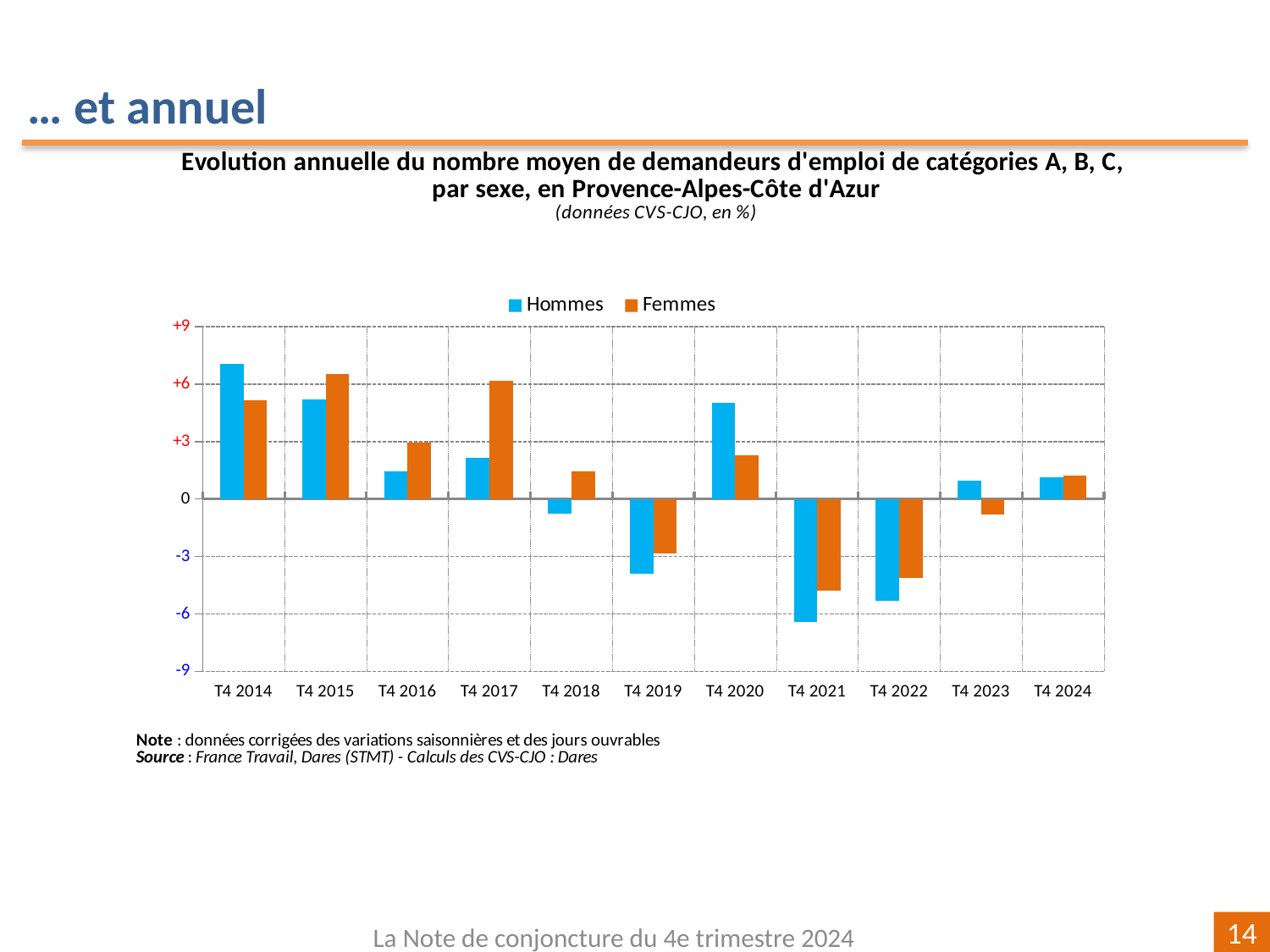
What kind of chart is shown on the slide? bar chart Is the Femmes value for T4 2021 greater or less than -3? less In which quarter is the Hommes value lowest? T4 2021 Is the Hommes value for T4 2014 greater or less than +6? greater In which quarter is the Femmes value lowest? T4 2021 For T4 2017, which series has the larger value, Hommes or Femmes? Femmes How many quarters (categories) are shown on the x axis? 11 Which colour represents the Hommes series in the legend? blue How many series does the legend list? 2 For T4 2020, which series has the larger value, Hommes or Femmes? Hommes Is the Hommes value for T4 2020 greater or less than +3? greater In which quarter is the Hommes value highest? T4 2014